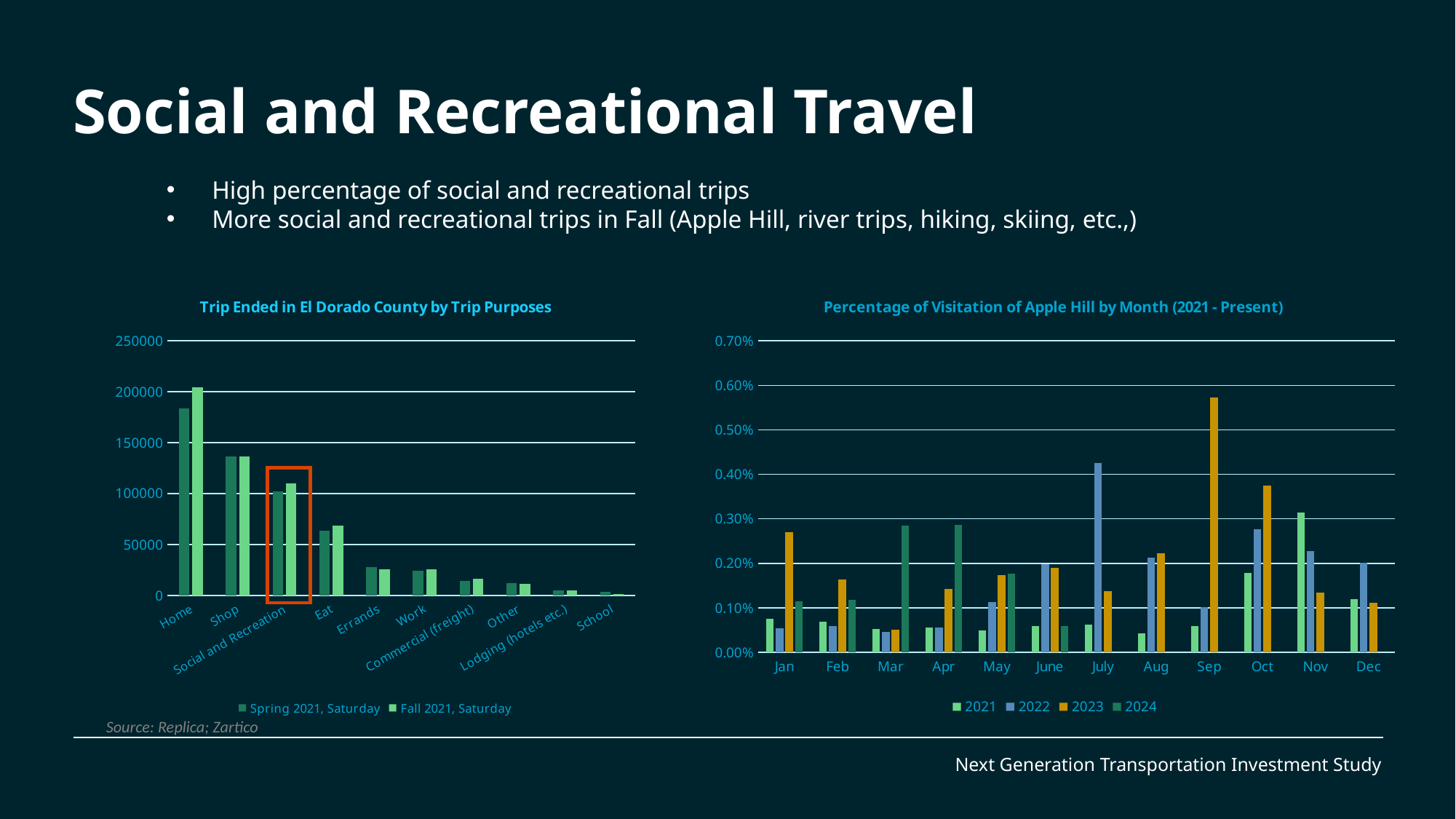
How many series does the legend of the 'Percentage of Visitation of Apple Hill by Month (2021 - Present)' chart list? 4 In the 'Percentage of Visitation of Apple Hill by Month (2021 - Present)' chart, which month has the highest 2022 value? July In the 'Trip Ended in El Dorado County by Trip Purposes' chart, is the Fall 2021, Saturday value for Home greater or less than 200000? greater In the 'Trip Ended in El Dorado County by Trip Purposes' chart, which is larger for Social and Recreation: Spring 2021, Saturday or Fall 2021, Saturday? Fall 2021, Saturday In the 'Trip Ended in El Dorado County by Trip Purposes' chart, which trip purpose has the highest number of trips for Fall 2021, Saturday? Home In the 'Trip Ended in El Dorado County by Trip Purposes' chart, which trip purpose has the lowest number of trips for Spring 2021, Saturday? School What kind of chart is the 'Trip Ended in El Dorado County by Trip Purposes' chart? bar chart How many series does the legend of the 'Trip Ended in El Dorado County by Trip Purposes' chart list? 2 In the 'Percentage of Visitation of Apple Hill by Month (2021 - Present)' chart, which month has the highest 2023 value? Sep In the 'Percentage of Visitation of Apple Hill by Month (2021 - Present)' chart, is the 2023 value for Sep greater or less than 0.50%? greater In the 'Trip Ended in El Dorado County by Trip Purposes' chart, which category is highlighted with a red box? Social and Recreation How many trip purpose categories are shown in the 'Trip Ended in El Dorado County by Trip Purposes' chart? 10